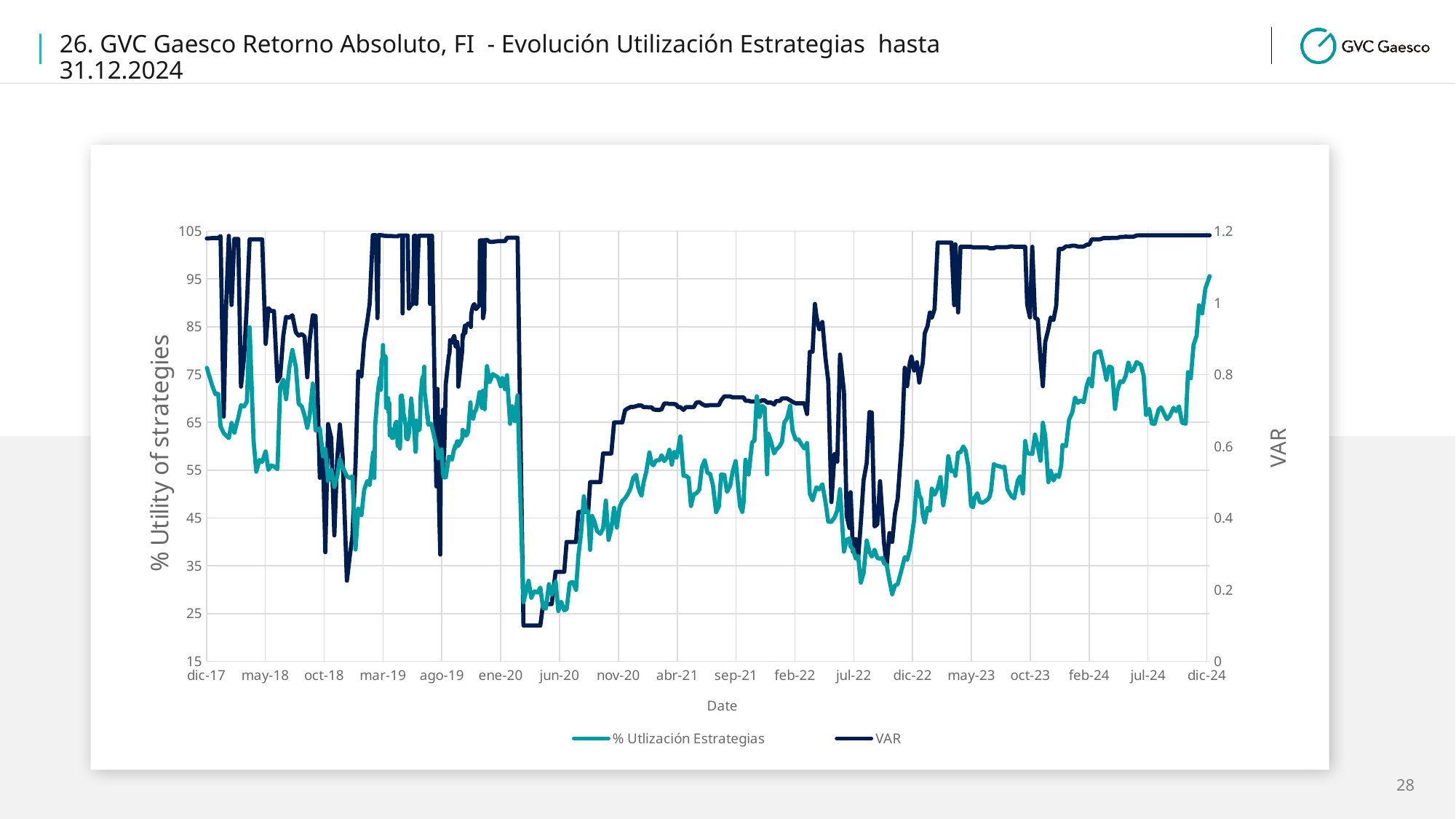
How many series does the legend list? 2 Is the value of % Utlización Estrategias around jun-20 greater or less than 35? less What are the two series named in the legend? % Utlización Estrategias and VAR Is the value of % Utlización Estrategias at dic-24 greater or less than 85? greater What kind of chart is shown on the slide? Line chart Does the % Utlización Estrategias line rise or fall between jul-24 and dic-24? rise Does the % Utlización Estrategias line rise or fall between jun-20 and sep-21? rise Is the VAR value at dic-24 greater or less than 1? greater How many date labels are shown on the x axis? 18 What is the title of the left vertical axis? % Utility of strategies